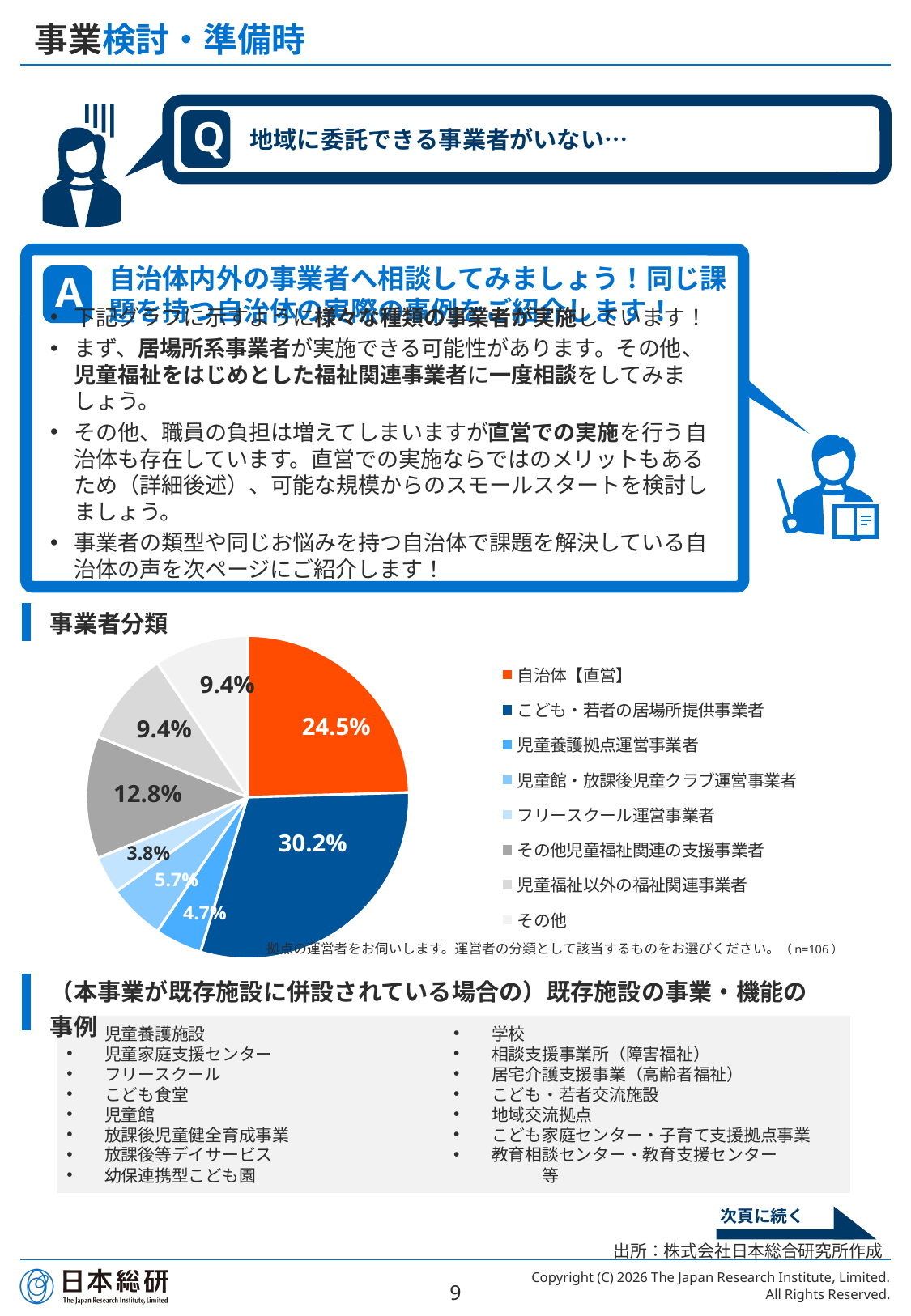
Which category has the largest slice in the 事業者分類 pie chart? こども・若者の居場所提供事業者 In the 事業者分類 pie chart, which is larger: 児童館・放課後児童クラブ運営事業者 or 児童養護拠点運営事業者? 児童館・放課後児童クラブ運営事業者 Which category has the smallest slice in the 事業者分類 pie chart? フリースクール運営事業者 What type of chart is shown under the heading 事業者分類? pie chart In the 事業者分類 pie chart, what share is shown for 自治体【直営】? 24.5% In the 事業者分類 pie chart, what share is shown for 児童養護拠点運営事業者? 4.7% In the 事業者分類 pie chart, what share is shown for その他児童福祉関連の支援事業者? 12.8% What colour is the slice for 自治体【直営】 in the 事業者分類 pie chart? orange In the 事業者分類 pie chart, what share is shown for フリースクール運営事業者? 3.8% In the 事業者分類 pie chart, what is the difference between the shares of こども・若者の居場所提供事業者 and 自治体【直営】? 5.7% How many categories does the legend of the 事業者分類 pie chart list? 8 In the 事業者分類 pie chart, what share is shown for こども・若者の居場所提供事業者? 30.2%